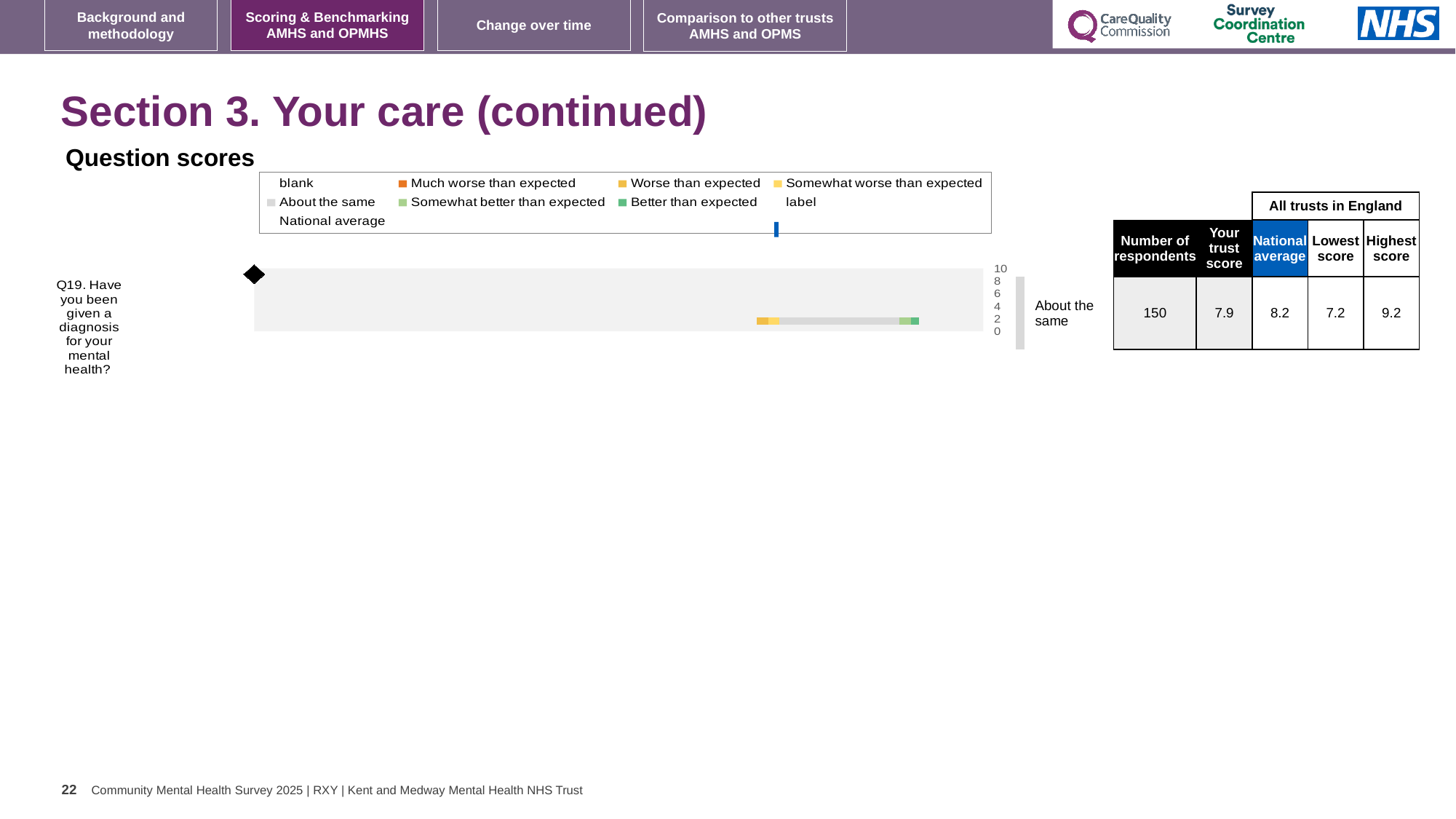
What is the trust score for Q19 (Have you been given a diagnosis for your mental health?)? 7.9 Which is larger for Q19: the trust score or the national average? National average What is the national average score for Q19? 8.2 How many questions are plotted on the chart? 1 What kind of chart is used to show the question scores? Bar chart What is the difference between the national average and the trust score for Q19? 0.3 What is the lowest score among all trusts in England for Q19? 7.2 What benchmark category is the trust's Q19 score placed in? About the same What is the highest score among all trusts in England for Q19? 9.2 What is the difference between the highest and lowest scores for Q19 across all trusts in England? 2.0 Is the trust score for Q19 greater or less than 6? greater How many respondents answered Q19? 150